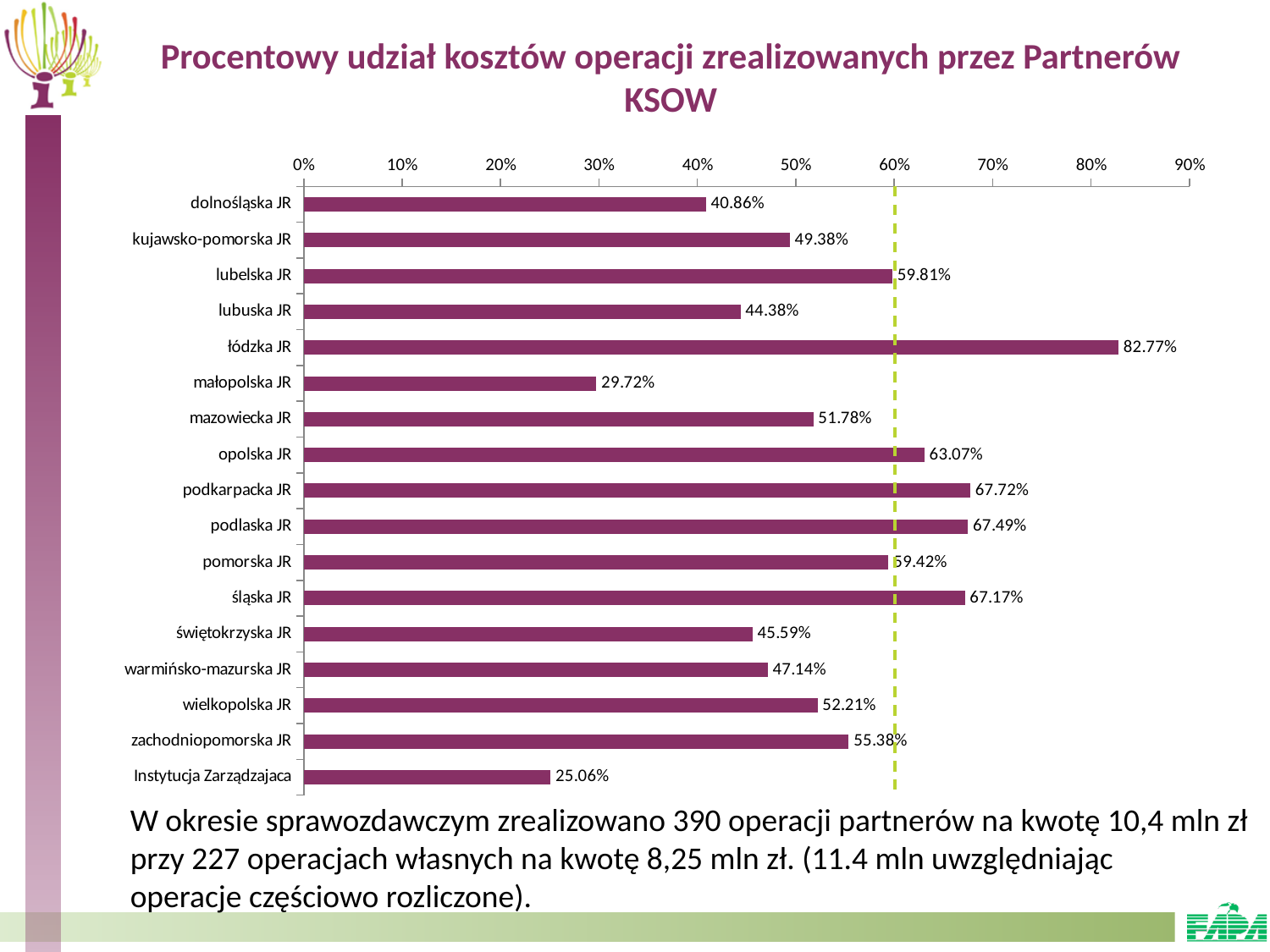
What is the value for mazowiecka JR? 51.78% What is the value for warmińsko-mazurska JR? 47.14% At what axis value is the dashed vertical reference line drawn? 60% What is the value for Instytucja Zarządzajaca? 25.06% Which is larger, the value for opolska JR or the value for lubuska JR? opolska JR How many categories are shown on the chart? 17 Is the value for zachodniopomorska JR greater or less than 50%? greater Which category has the highest value? łódzka JR Which category has the lowest value? Instytucja Zarządzajaca What is the value for łódzka JR? 82.77% What is the difference between the values for łódzka JR and małopolska JR? 53.05 percentage points What kind of chart is shown on the slide? bar chart